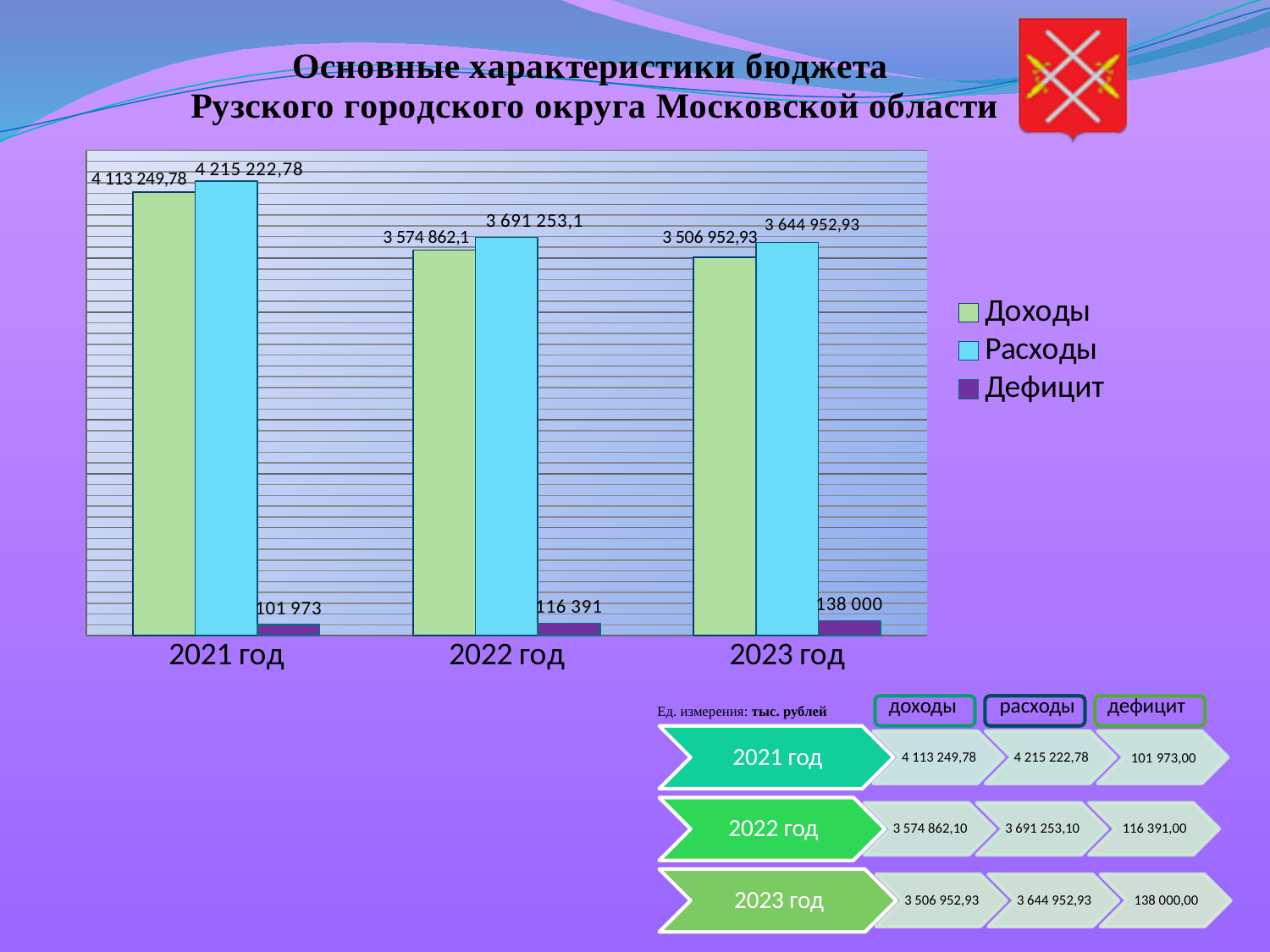
What is the value of Расходы for 2022 год? 3 691 253,1 Which is larger for 2022 год: Доходы or Расходы? Расходы What is the value of Расходы for 2023 год? 3 644 952,93 What kind of chart is shown on the slide? Bar chart How many series does the legend list? 3 How many years are shown on the x axis? 3 What is the value of Доходы for 2021 год? 4 113 249,78 In which year is Дефицит the lowest? 2021 год In which year is Доходы the highest? 2021 год What is the difference between Дефицит in 2023 год and Дефицит in 2021 год? 36 027 What is the value of Дефицит for 2023 год? 138 000 What is the difference between Расходы and Доходы for 2023 год? 138 000